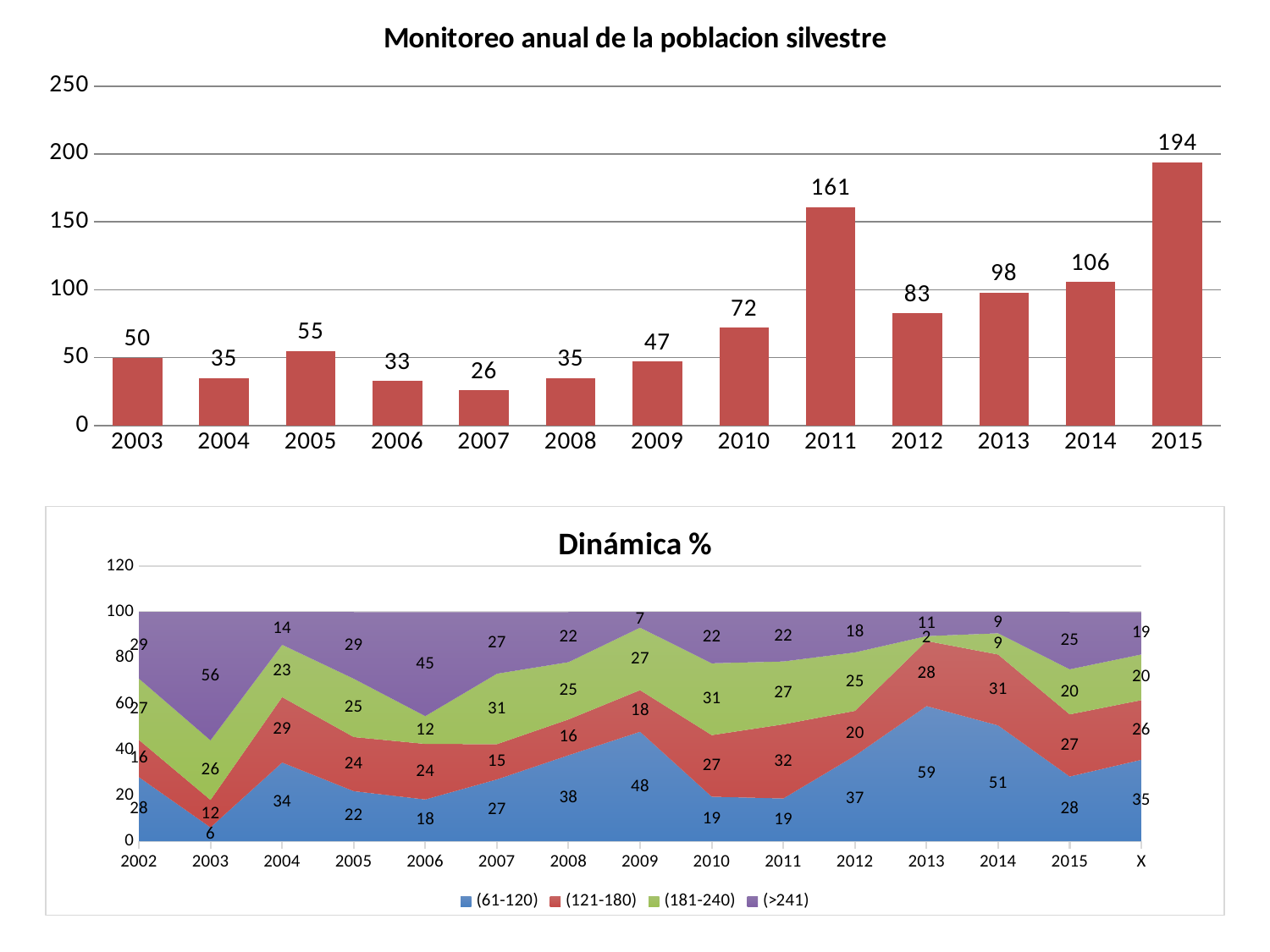
In the chart 'Monitoreo anual de la poblacion silvestre', what is the difference between the values for 2015 and 2014? 88 What kind of chart is 'Monitoreo anual de la poblacion silvestre'? Bar chart In the chart 'Monitoreo anual de la poblacion silvestre', which is larger, the value for 2012 or the value for 2013? 2013 In the chart 'Dinámica %', how many categories are shown on the x axis? 15 In the chart 'Monitoreo anual de la poblacion silvestre', which year has the lowest value? 2007 In the chart 'Dinámica %', what is the value of the (>241) series for 2003? 56 In the chart 'Dinámica %', how many series does the legend list? 4 In the chart 'Dinámica %', what is the value of the (61-120) series for 2013? 59 In the chart 'Monitoreo anual de la poblacion silvestre', what is the value for 2011? 161 In the chart 'Monitoreo anual de la poblacion silvestre', how many years are shown on the x axis? 13 In the chart 'Dinámica %', which series is shown in purple? (>241) In the chart 'Monitoreo anual de la poblacion silvestre', which year has the highest value? 2015